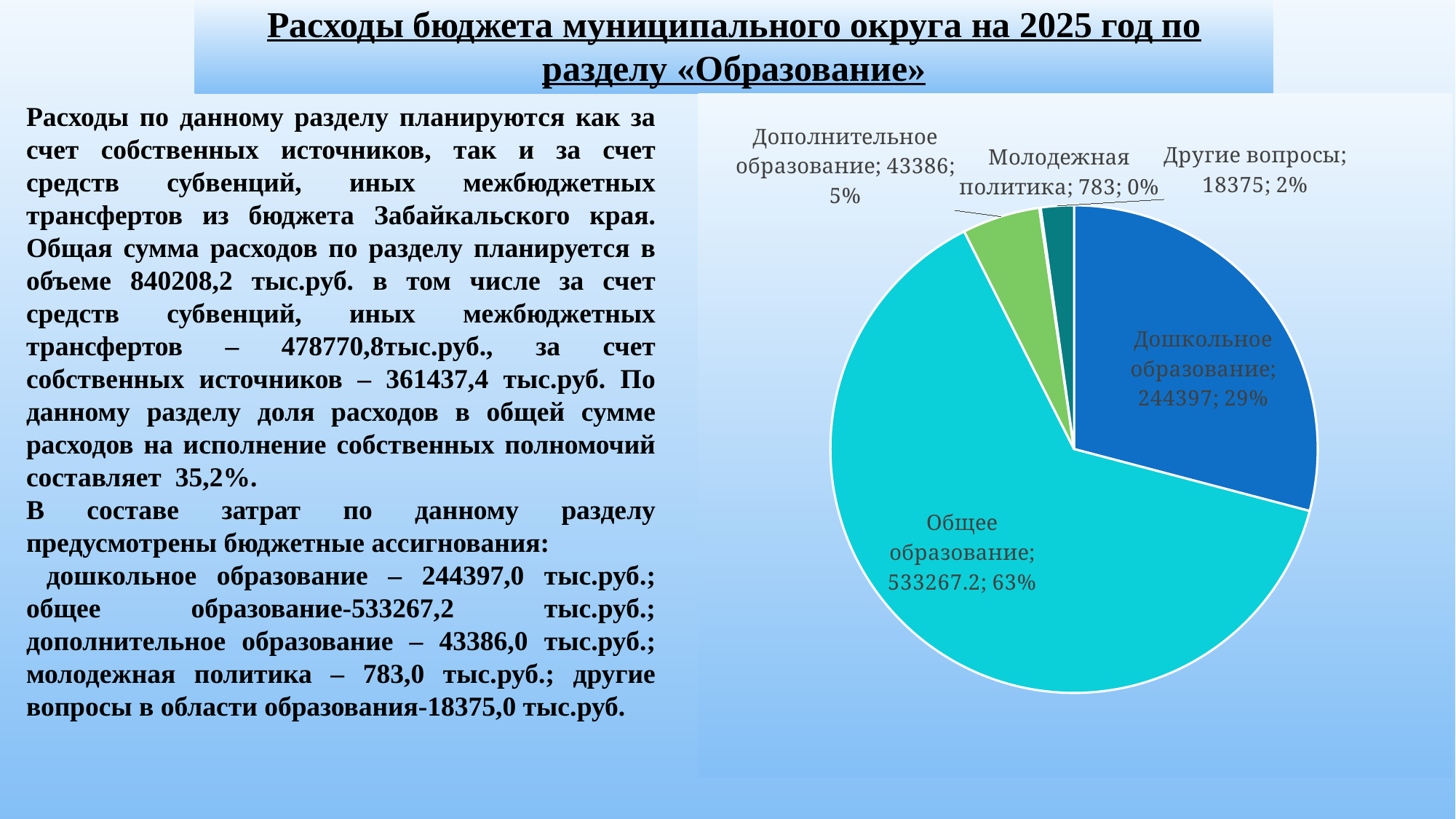
How many slices does the pie chart have? 5 What is the value shown for Дошкольное образование in the pie chart? 244397 What kind of chart is shown on the slide? pie chart What share of the pie does Общее образование represent? 63% What is the difference between the values for Дошкольное образование and Дополнительное образование? 201011 What is the value shown for Общее образование in the pie chart? 533267.2 What is the value shown for Молодежная политика in the pie chart? 783 Which category has the largest slice in the pie chart? Общее образование Which is larger, the value for Другие вопросы or the value for Молодежная политика? Другие вопросы What share of the pie does Другие вопросы represent? 2% What is the value shown for Дополнительное образование in the pie chart? 43386 Which category has the smallest slice in the pie chart? Молодежная политика